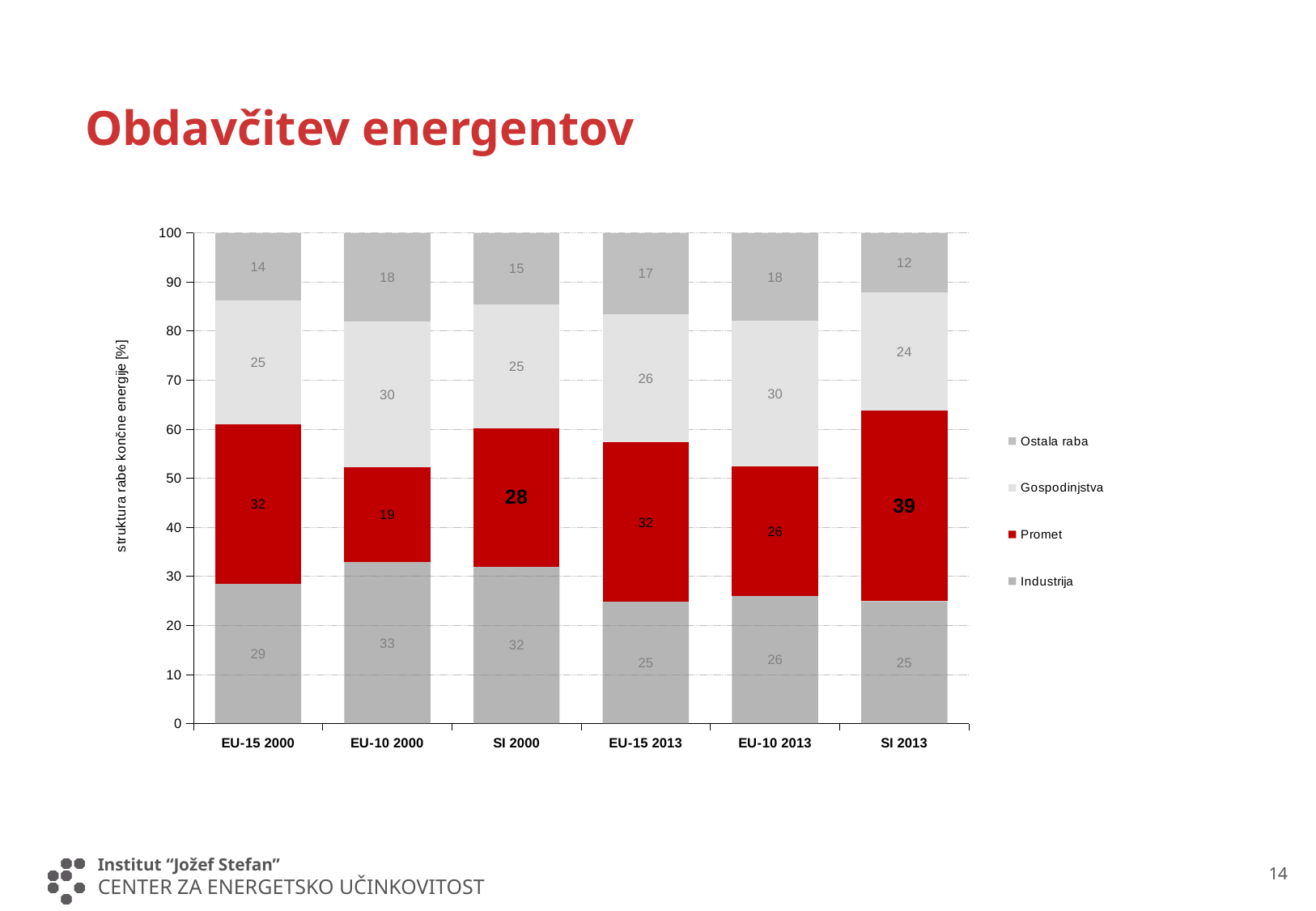
Which category has the lowest Promet value? EU-10 2000 How many categories are shown on the x axis? 6 What is the total of the stacked bar for EU-10 2013? 100 What is the difference between the Promet values for SI 2013 and SI 2000? 11 What is the Gospodinjstva value for EU-15 2013? 26 Which is larger, the Industrija value for EU-15 2000 or for EU-15 2013? EU-15 2000 What kind of chart is shown on the slide? Stacked bar chart What is the Ostala raba value for SI 2013? 12 Which category has the highest Promet value? SI 2013 What is the Promet value for SI 2013? 39 How many series does the legend list? 4 What is the Industrija value for EU-10 2000? 33